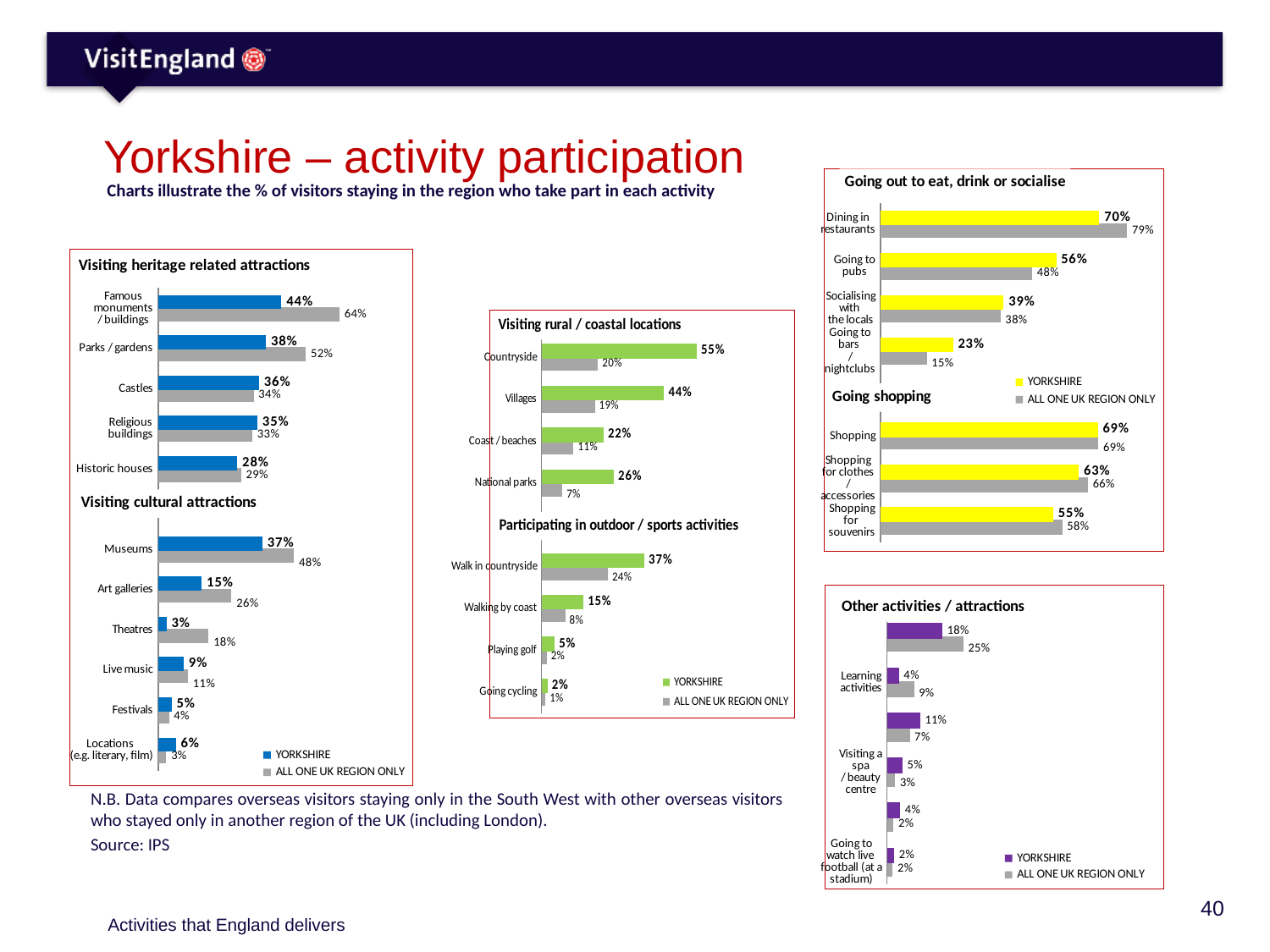
In the 'Visiting rural / coastal locations' chart, which category has the highest Yorkshire value? Countryside In the 'Other activities / attractions' chart, what is the ALL ONE UK REGION ONLY value for Learning activities? 9% In the 'Participating in outdoor / sports activities' chart, how many categories are shown? 4 In the 'Going out to eat, drink or socialise' chart, which is larger for Dining in restaurants: the Yorkshire value or the ALL ONE UK REGION ONLY value? ALL ONE UK REGION ONLY In the 'Going shopping' chart, what is the Yorkshire value for Shopping for souvenirs? 55% In the 'Visiting cultural attractions' chart, what is the ALL ONE UK REGION ONLY value for Art galleries? 26% In the 'Going out to eat, drink or socialise' chart, what is the Yorkshire value for Going to pubs? 56% In the 'Visiting rural / coastal locations' chart, what is the ALL ONE UK REGION ONLY value for National parks? 7% In the 'Visiting cultural attractions' chart, which category has the lowest Yorkshire value? Theatres In the 'Visiting heritage related attractions' chart, what is the difference between the ALL ONE UK REGION ONLY value and the Yorkshire value for Famous monuments / buildings? 20% In the 'Visiting heritage related attractions' chart, what is the Yorkshire value for Castles? 36% What type of chart is the 'Visiting heritage related attractions' chart? Bar chart